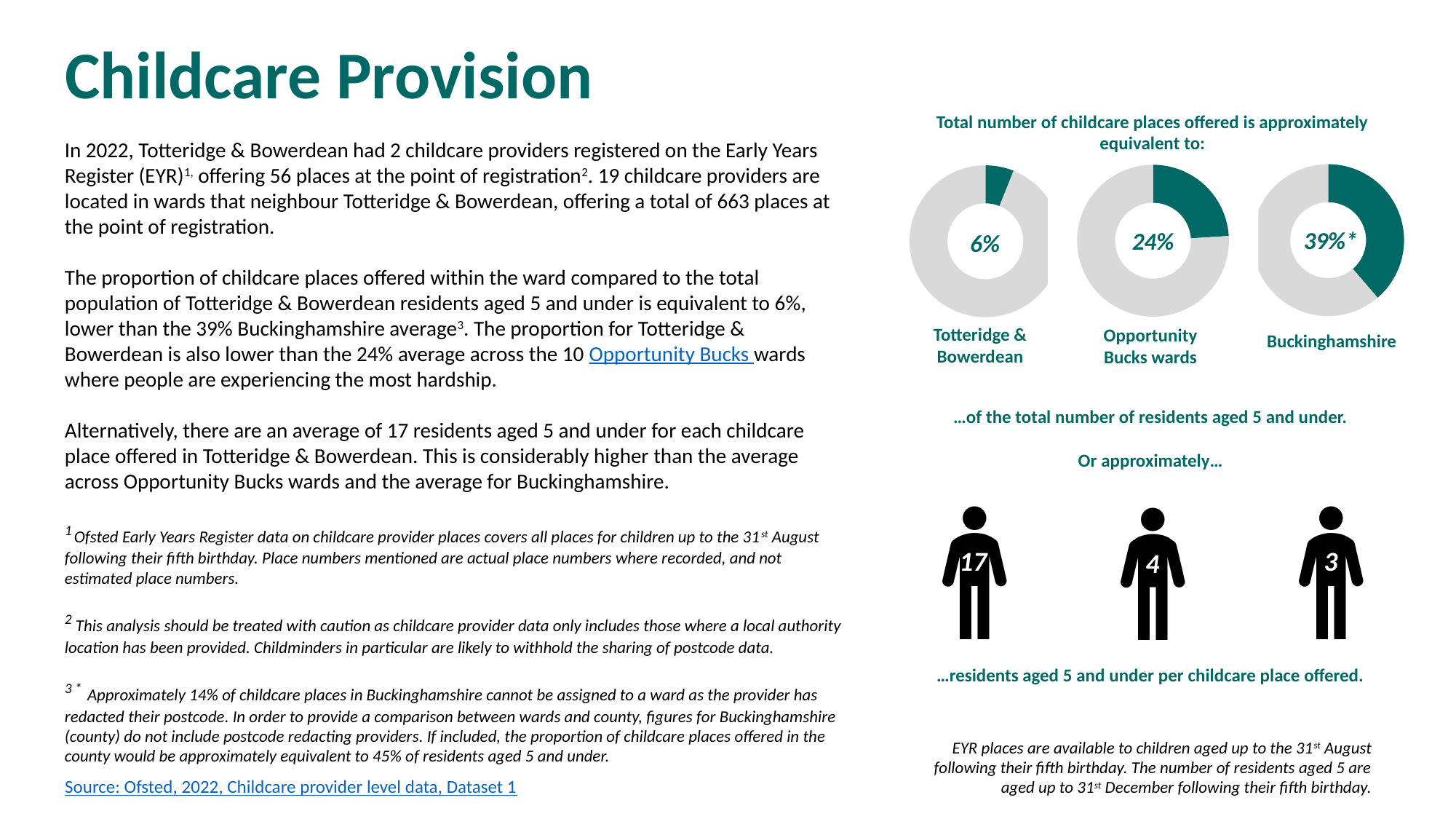
In the donut charts, what percentage is shown for Opportunity Bucks wards? 24% In the donut charts, what is the difference in percentage points between Buckinghamshire and Totteridge & Bowerdean? 33 What kind of chart is used to show the percentages of residents aged 5 and under? Donut (pie) chart In the pictogram figures, how many residents aged 5 and under per childcare place are shown for Totteridge & Bowerdean? 17 In the donut charts, which has the larger percentage: Opportunity Bucks wards or Totteridge & Bowerdean? Opportunity Bucks wards In the donut charts, what percentage is shown for Buckinghamshire? 39%* Among the three donut charts, which area has the lowest percentage? Totteridge & Bowerdean Among the three donut charts, which area has the highest percentage? Buckinghamshire In the pictogram figures, how many residents aged 5 and under per childcare place are shown for Buckinghamshire? 3 How many donut charts are shown on the slide? 3 What is the title above the donut charts? Total number of childcare places offered is approximately equivalent to: In the donut charts, what percentage is shown for Totteridge & Bowerdean? 6%